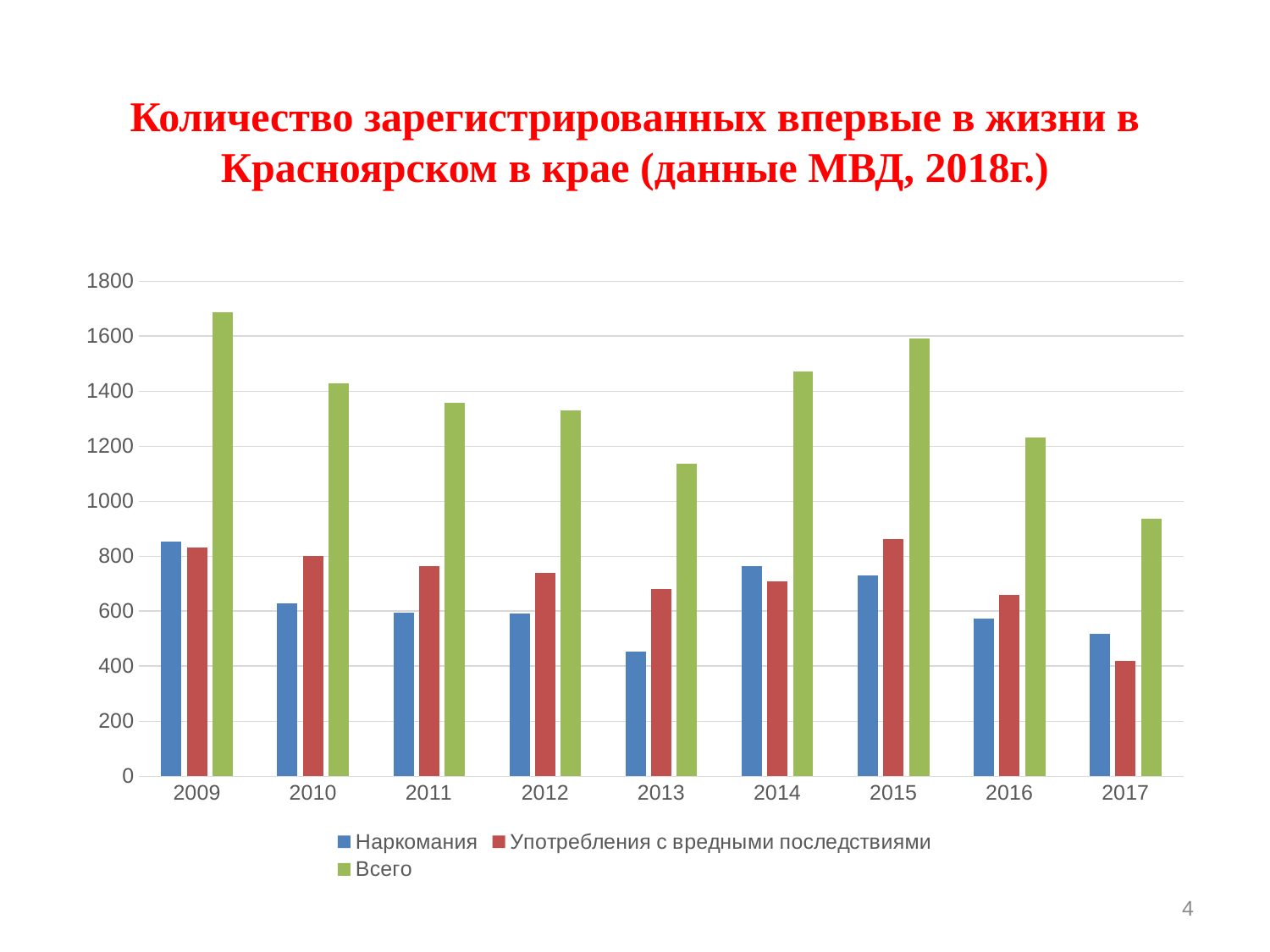
In which year is the value for Всего the lowest? 2017 In which year is the value for Наркомания the lowest? 2013 Is the value for Всего in 2017 greater or less than 1000? less Is the value for Всего in 2009 greater or less than 1600? greater In which year is the value for Употребления с вредными последствиями the lowest? 2017 What kind of chart is shown on the slide? Bar chart How many years are shown on the x axis? 9 How many series does the legend list? 3 In 2017, which is larger: Наркомания or Употребления с вредными последствиями? Наркомания Does the value for Наркомания rise or fall from 2009 to 2013? Fall In which year is the value for Всего the highest? 2009 Is the value for Наркомания in 2013 greater or less than 600? less